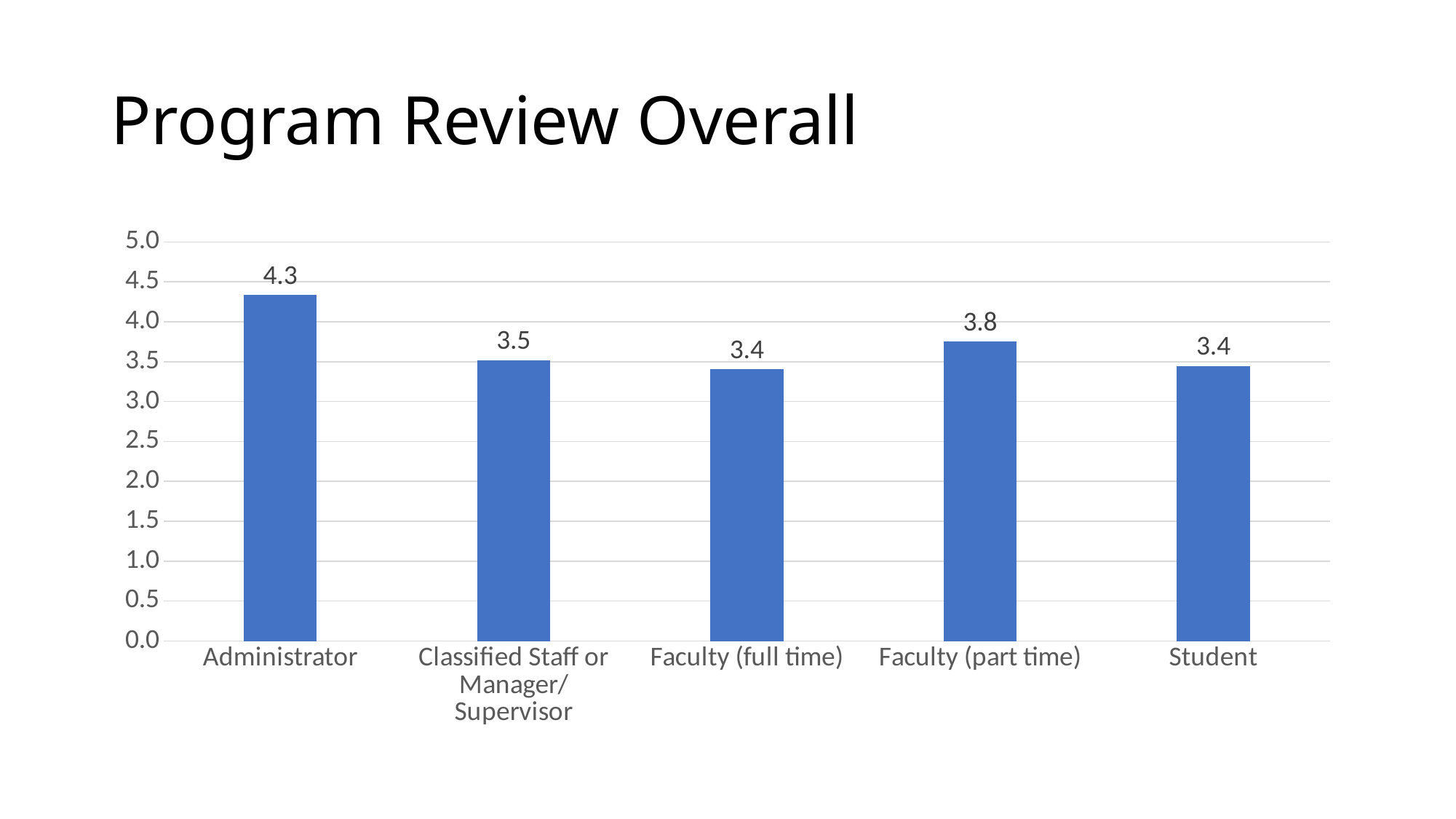
What is the value for Classified Staff or Manager/Supervisor? 3.5 What is the difference between the values for Faculty (part time) and Faculty (full time)? 0.4 What kind of chart is shown on the slide? bar chart What is the value for Faculty (part time)? 3.8 How many categories are shown on the x axis? 5 Which category has the highest value? Administrator What is the title of the slide? Program Review Overall Is the value for Administrator greater or less than 4.0? greater What is the value for Student? 3.4 What is the value for Administrator? 4.3 Which is larger, the value for Faculty (part time) or the value for Classified Staff or Manager/Supervisor? Faculty (part time) What is the difference between the values for Administrator and Faculty (part time)? 0.5